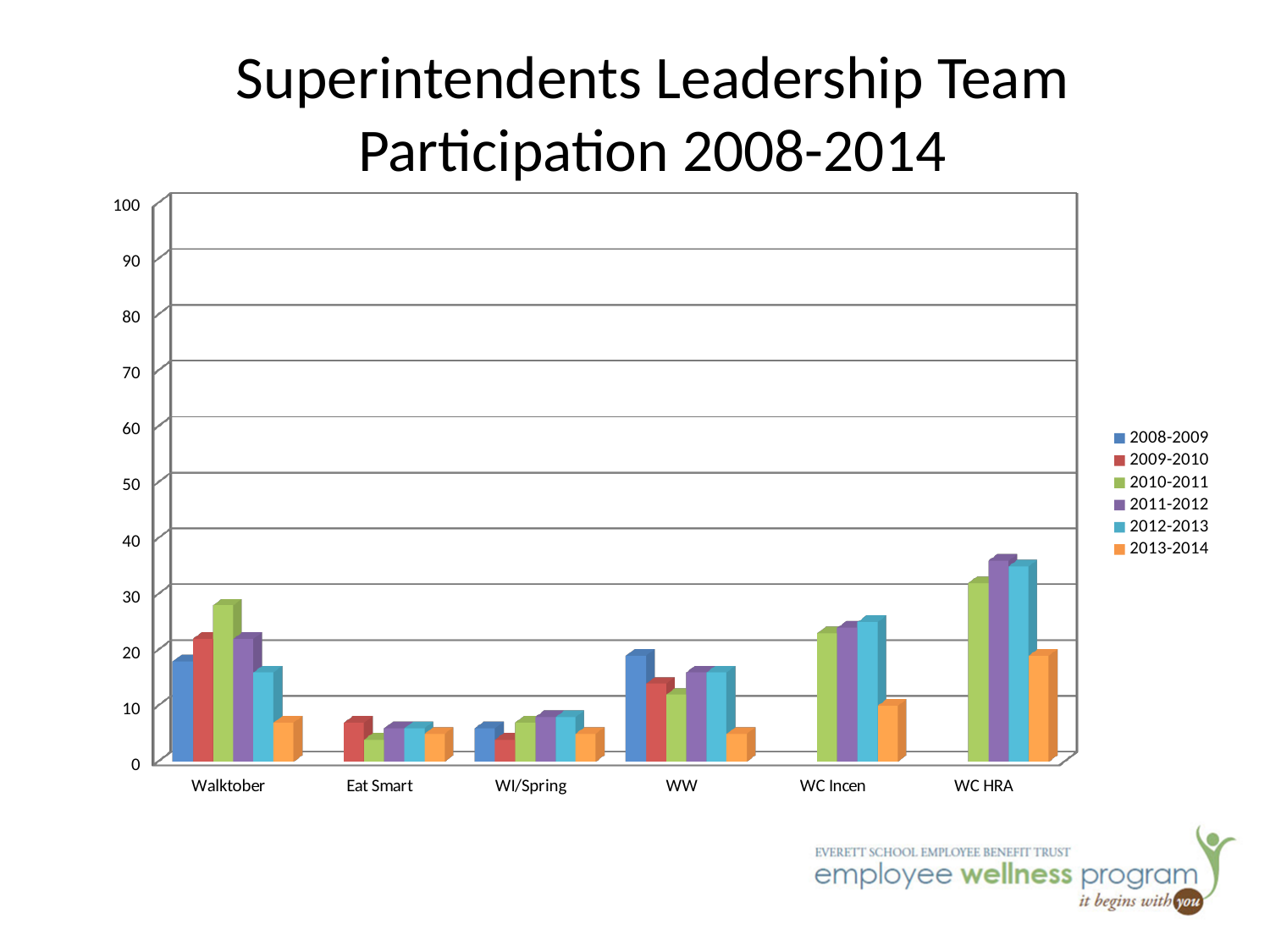
Is the value for Walktober in 2010-2011 greater or less than 20? greater How many categories are shown along the x axis? 6 Which category contains the tallest bar in the chart? WC HRA What is the title of the chart? Superintendents Leadership Team Participation 2008-2014 For Walktober, which is larger: the 2010-2011 value or the 2013-2014 value? 2010-2011 Is the value for Eat Smart in 2009-2010 greater or less than 10? less What kind of chart is shown on the slide? bar chart Is the value for WC HRA in 2013-2014 greater or less than 10? greater For WW, which is larger: the 2008-2009 value or the 2013-2014 value? 2008-2009 How many series does the legend list? 6